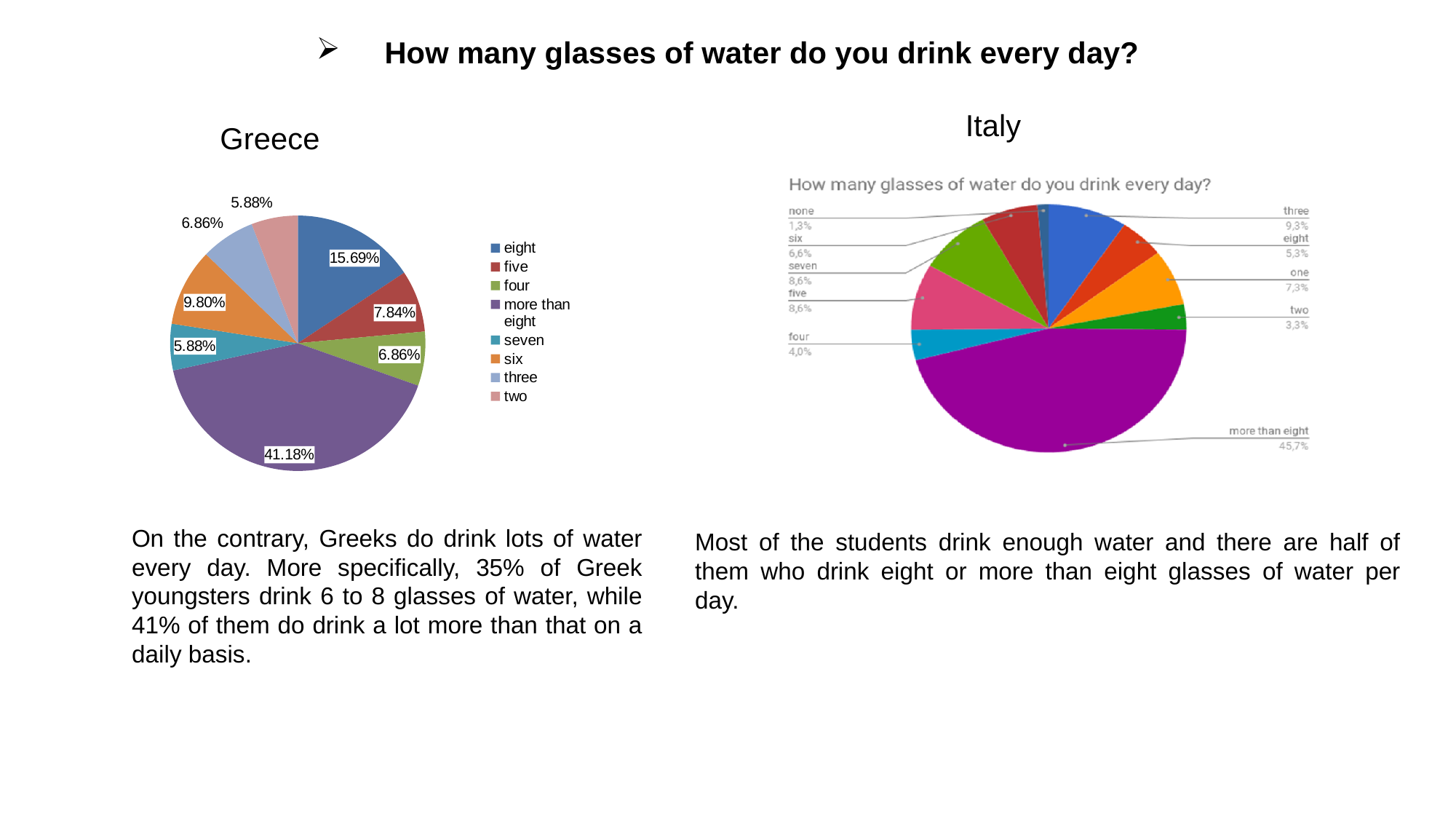
In the Greece chart, how many categories does the legend list? 8 In the Greece chart, which is larger, the 'six' slice or the 'four' slice? six In the Greece chart, what percentage is shown for 'six' glasses? 9.80% In the Italy chart, what percentage is shown for 'none'? 1,3% In the Greece chart, what share of respondents drink more than eight glasses of water a day? 41.18% What type of chart is used for both Greece and Italy on this slide? pie chart In the Italy chart, which category has the smallest share? none In the Italy chart, what percentage of students drink more than eight glasses of water a day? 45,7% In the Greece chart, which category has the largest slice? more than eight In the Greece chart, what is the difference between the 'eight' slice and the 'five' slice? 7.85% In the Greece chart, what percentage is shown for the 'eight' slice? 15.69% In the Italy chart, how many categories are labelled around the pie? 10